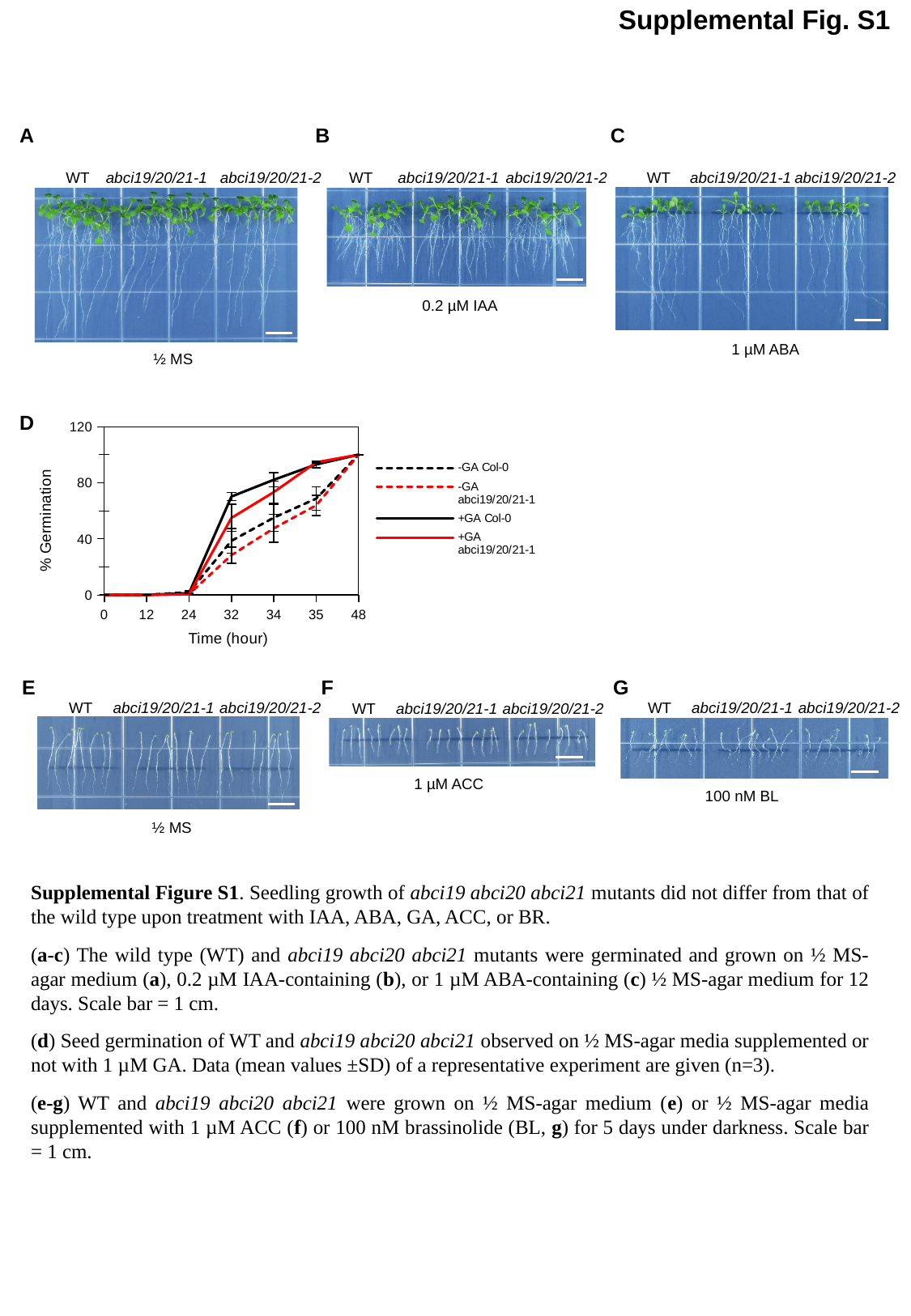
In panel D, what is the label of the y axis? % Germination In panel D, do the % Germination values rise or fall as time increases from 24 to 48 hours? rise In panel D, how many series does the legend list? 4 In panel D, is the value for -GA abci19/20/21-1 at 32 hours greater or less than 40? less What kind of chart is panel D? line chart In panel D, at 32 hours, which is larger: +GA Col-0 or -GA Col-0? +GA Col-0 In panel D, is the value for +GA Col-0 at 32 hours greater or less than 40? greater In panel D, is the value for +GA Col-0 at 35 hours greater or less than 80? greater In panel D, what is the % Germination for +GA Col-0 at 12 hours? 0 In panel D, how many time points are marked on the x axis? 7